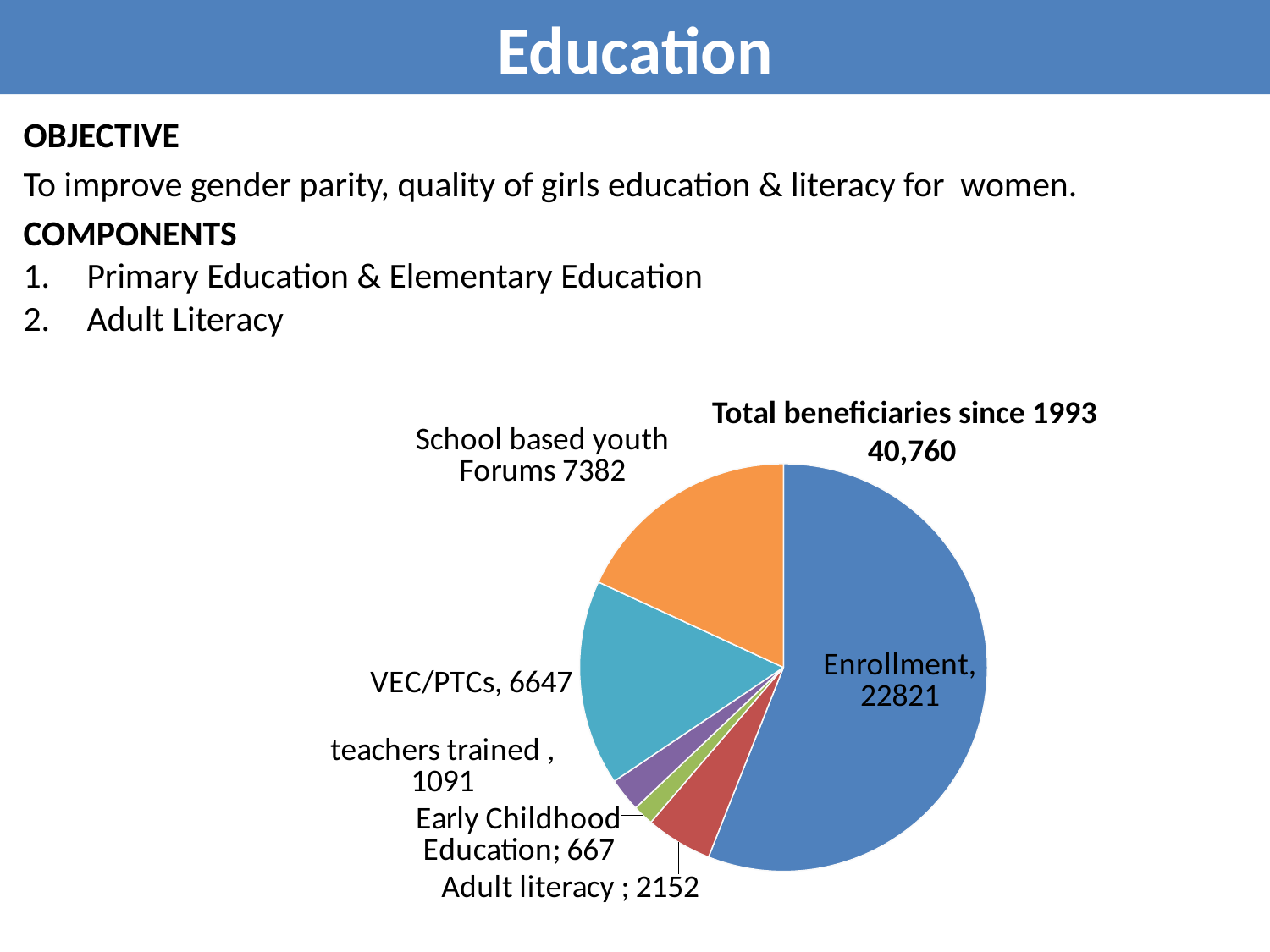
What is the value for Enrollment in the pie chart? 22821 What is the value for teachers trained in the pie chart? 1091 What total number of beneficiaries since 1993 is stated in the chart title? 40,760 What is the value for VEC/PTCs in the pie chart? 6647 What is the difference between the values for School based youth Forums and VEC/PTCs? 735 What is the value for School based youth Forums in the pie chart? 7382 Which is larger, the value for Adult literacy or the value for teachers trained? Adult literacy What is the value for Adult literacy in the pie chart? 2152 Which category has the largest slice of the pie chart? Enrollment How many slices does the pie chart have? 6 Which category has the smallest slice of the pie chart? Early Childhood Education What type of chart is shown on the slide? pie chart